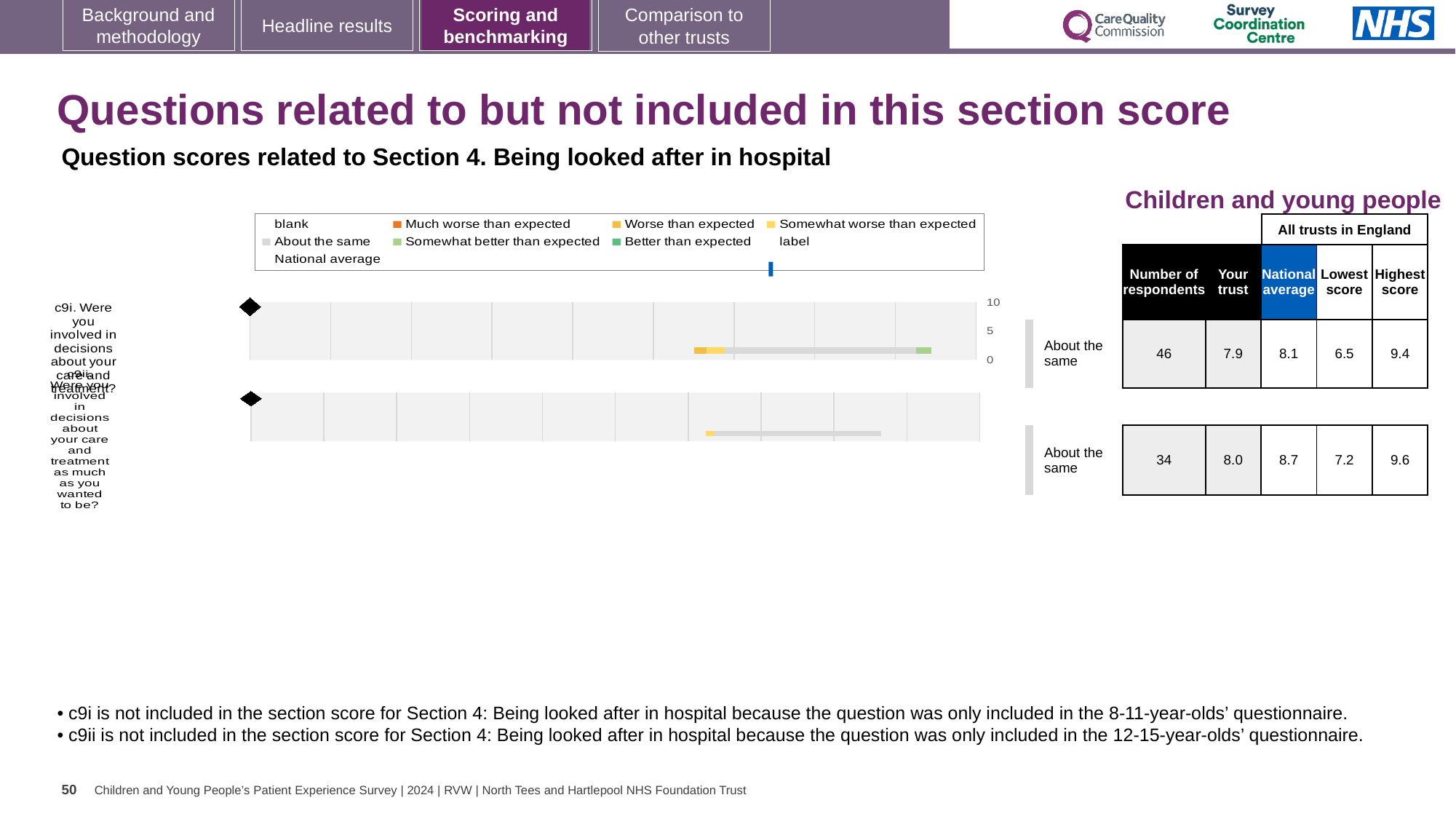
Which is larger for question c9i: the 'Your trust' score or the national average? National average What is the maximum value shown on the chart's score axis? 10 What is the lowest score among all trusts in England for question c9i? 6.5 What kind of chart is used to show the question scores for c9i and c9ii? bar chart What is the difference between the highest and lowest scores for question c9i? 2.9 What is the highest score among all trusts in England for question c9ii? 9.6 What is the difference between the national average and the 'Your trust' score for question c9ii? 0.7 What is the 'Your trust' score for question c9i? 7.9 How many questions (bars) are plotted in the chart area? 2 What is the national average score for question c9ii? 8.7 How many respondents answered question c9i? 46 What benchmark category is shown next to the bar for question c9ii? About the same